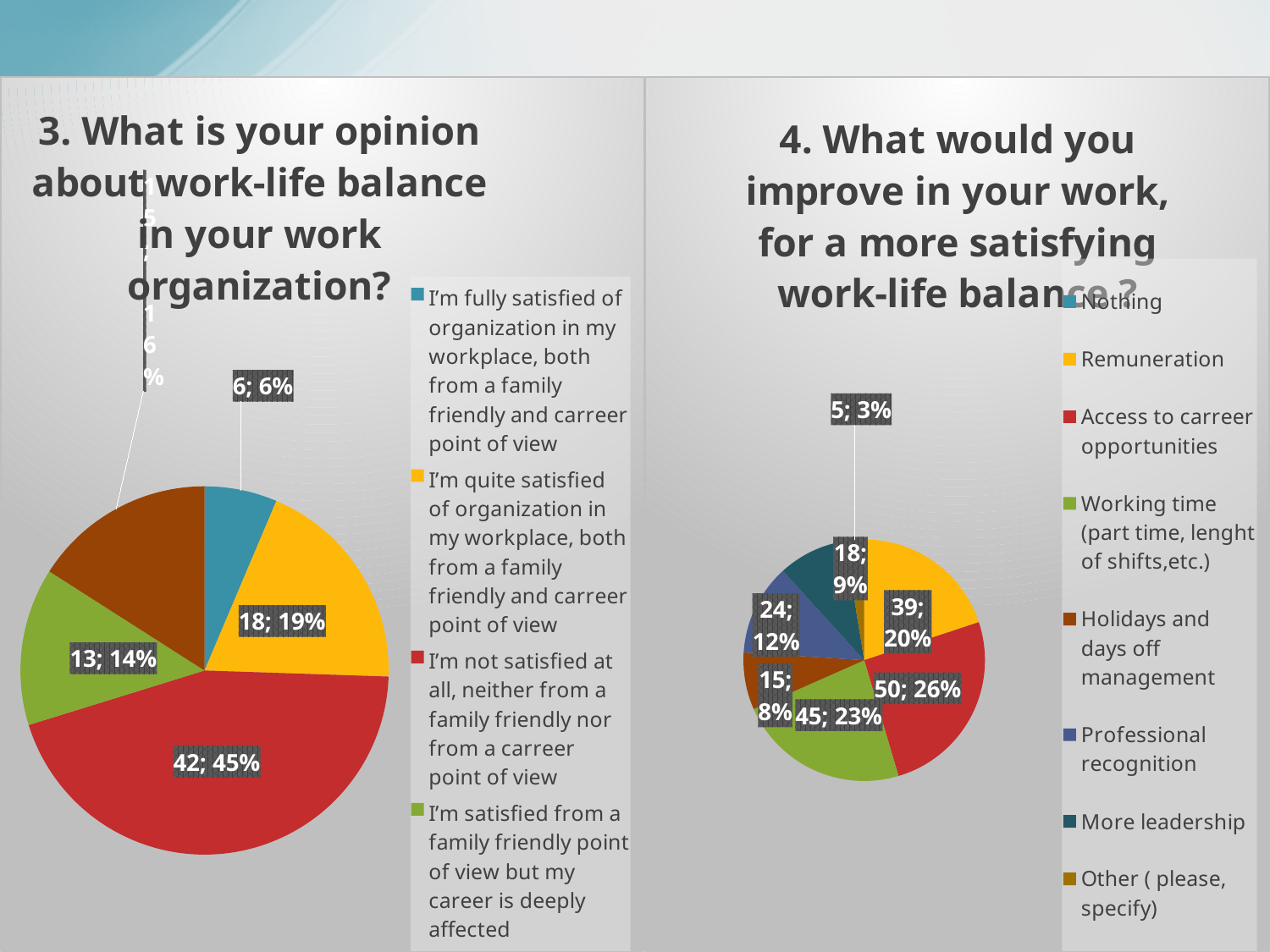
In the chart for question 3 (left), which is larger: the share who are quite satisfied, or the share who are satisfied from a family friendly point of view but whose career is deeply affected? Quite satisfied In the chart for question 3 (left), how many respondents are fully satisfied with the organization in their workplace? 6 In the chart for question 4 (right), which is larger: Working time or Professional recognition? Working time How many entries does the legend of the chart for question 4 (right) list? 8 In the chart for question 4 (right), what percentage is shown for Holidays and days off management? 8% In the chart for question 4 (right), what percentage of responses is for Remuneration? 20% In the chart for question 4 (right), what is the difference in the number of responses between Access to career opportunities and Remuneration? 11 In the chart for question 4 (right), which improvement has the largest slice? Access to career opportunities In the chart for question 4 (right), how many responses are for Access to career opportunities? 50 What type of chart is used for question 3 (left)? Pie chart In the chart for question 4 (right), what percentage is shown for More leadership? 9% In the chart for question 3 (left), what percentage of respondents are not satisfied at all? 45%